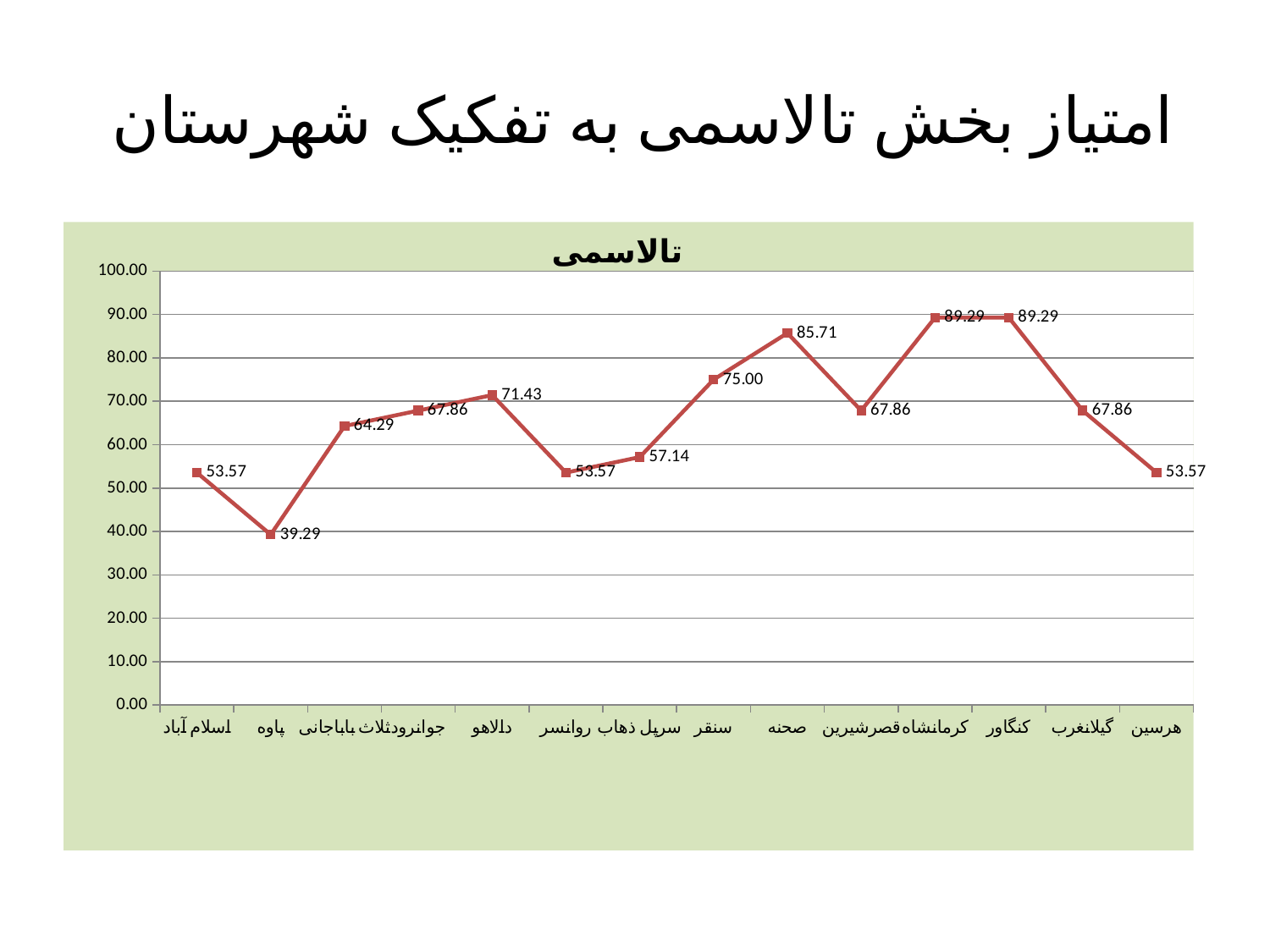
What is the value for صحنه? 85.71 What is the difference between the values for صحنه and قصرشیرین? 17.85 What is the value for سنقر? 75.00 Is the value for کنگاور greater or less than 80.00? greater What kind of chart is shown? line chart What is the title shown inside the chart area? تالاسمی What is the value for دالاهو? 71.43 Which is larger, the value for سرپل ذهاب or the value for ثلاث باباجانی? ثلاث باباجانی Which category has the lowest value? پاوه What is the difference between the values for کرمانشاه and هرسین? 35.72 What is the value for پاوه? 39.29 How many categories are shown on the x axis? 14